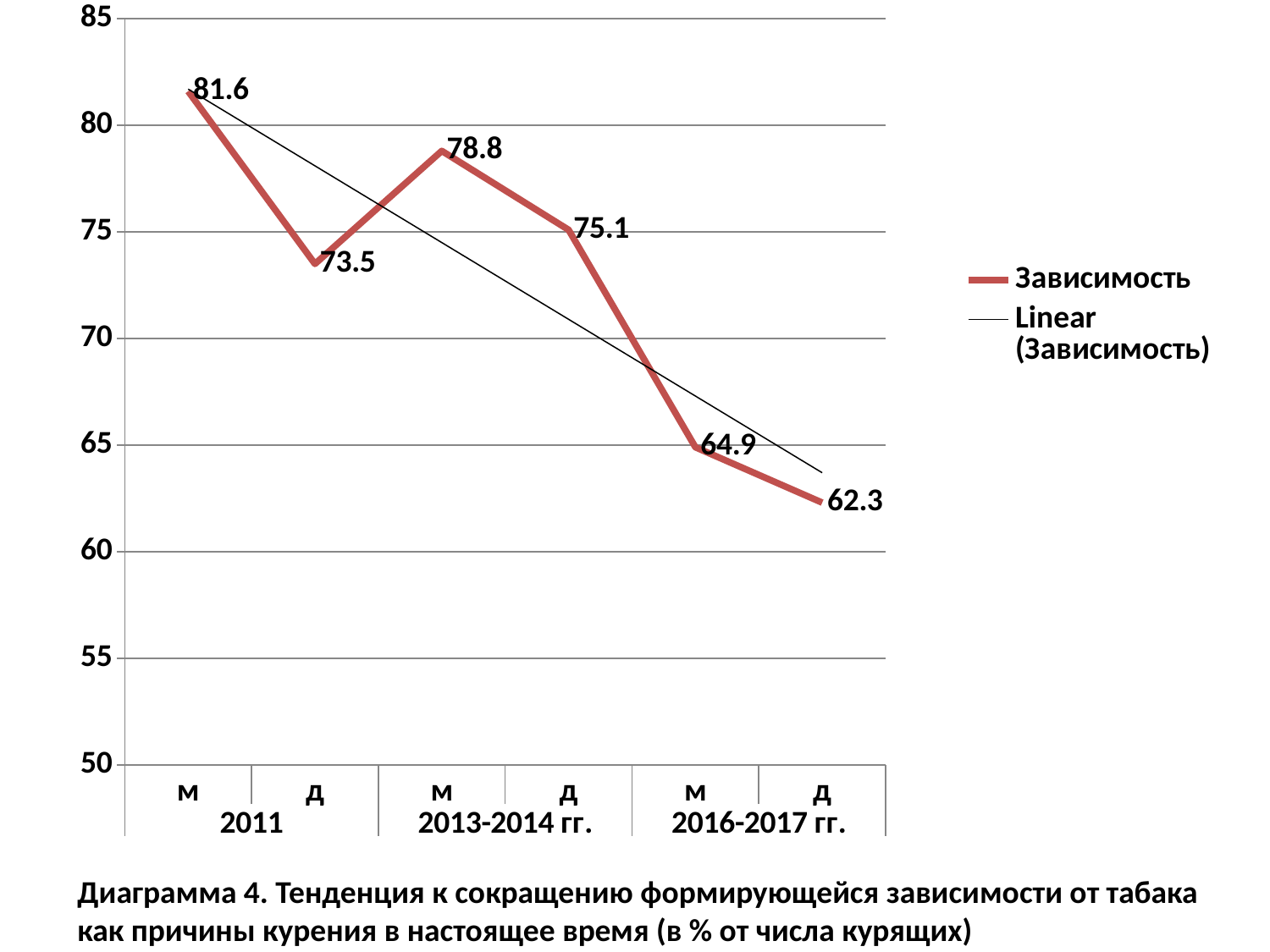
Which is larger: the value for д in 2011 or the value for м in 2013-2014 гг.? м in 2013-2014 гг. What is the value for д in 2016-2017 гг.? 62.3 Which point has the highest value? м 2011 What kind of chart is shown on the slide? Line chart What is the difference between the value for м in 2011 and the value for д in 2011? 8.1 What is the difference between the value for м in 2013-2014 гг. and the value for д in 2016-2017 гг.? 16.5 How many series does the legend list? 2 How many data points are plotted on the Зависимость line? 6 What is the value for д in 2013-2014 гг.? 75.1 What is the value for м in 2011? 81.6 Which point has the lowest value? д 2016-2017 гг. What is the value for м in 2016-2017 гг.? 64.9